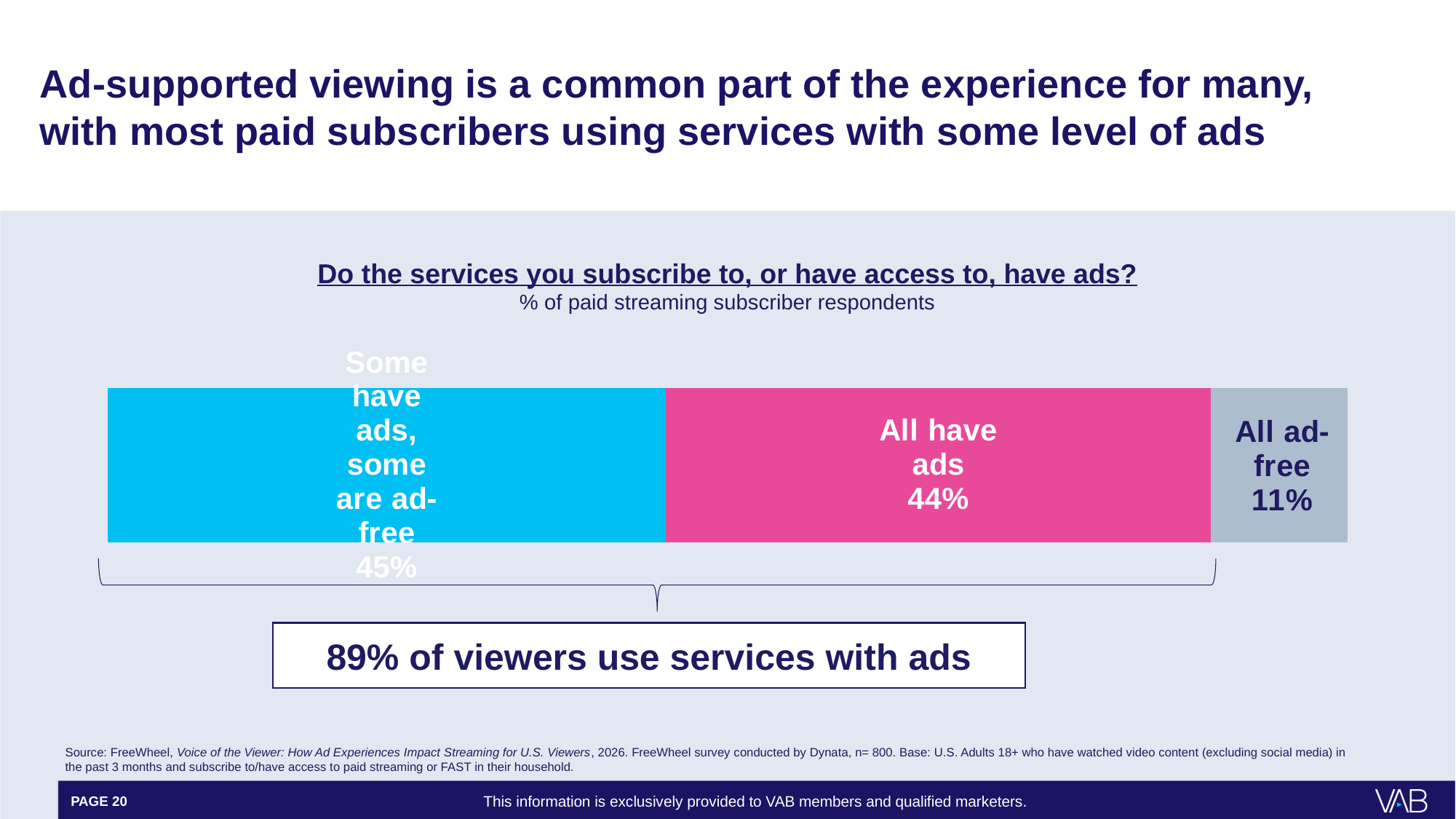
Which response category has the largest share of respondents? Some have ads, some are ad-free What is the difference in percentage points between 'Some have ads, some are ad-free' and 'All have ads'? 1 What percentage of respondents said some of their services have ads and some are ad-free? 45% Which response category has the smallest share of respondents? All ad-free What percentage of respondents said all of their services are ad-free? 11% What is the title of the chart? Do the services you subscribe to, or have access to, have ads? What is the combined percentage of respondents whose services have at least some ads? 89% What percentage of paid streaming subscriber respondents said all of their services have ads? 44% Which is larger: the share for 'All have ads' or the share for 'All ad-free'? All have ads How many response categories are shown in the bar? 3 What kind of chart is shown on the slide? Stacked bar chart What is the difference in percentage points between 'All have ads' and 'All ad-free'? 33